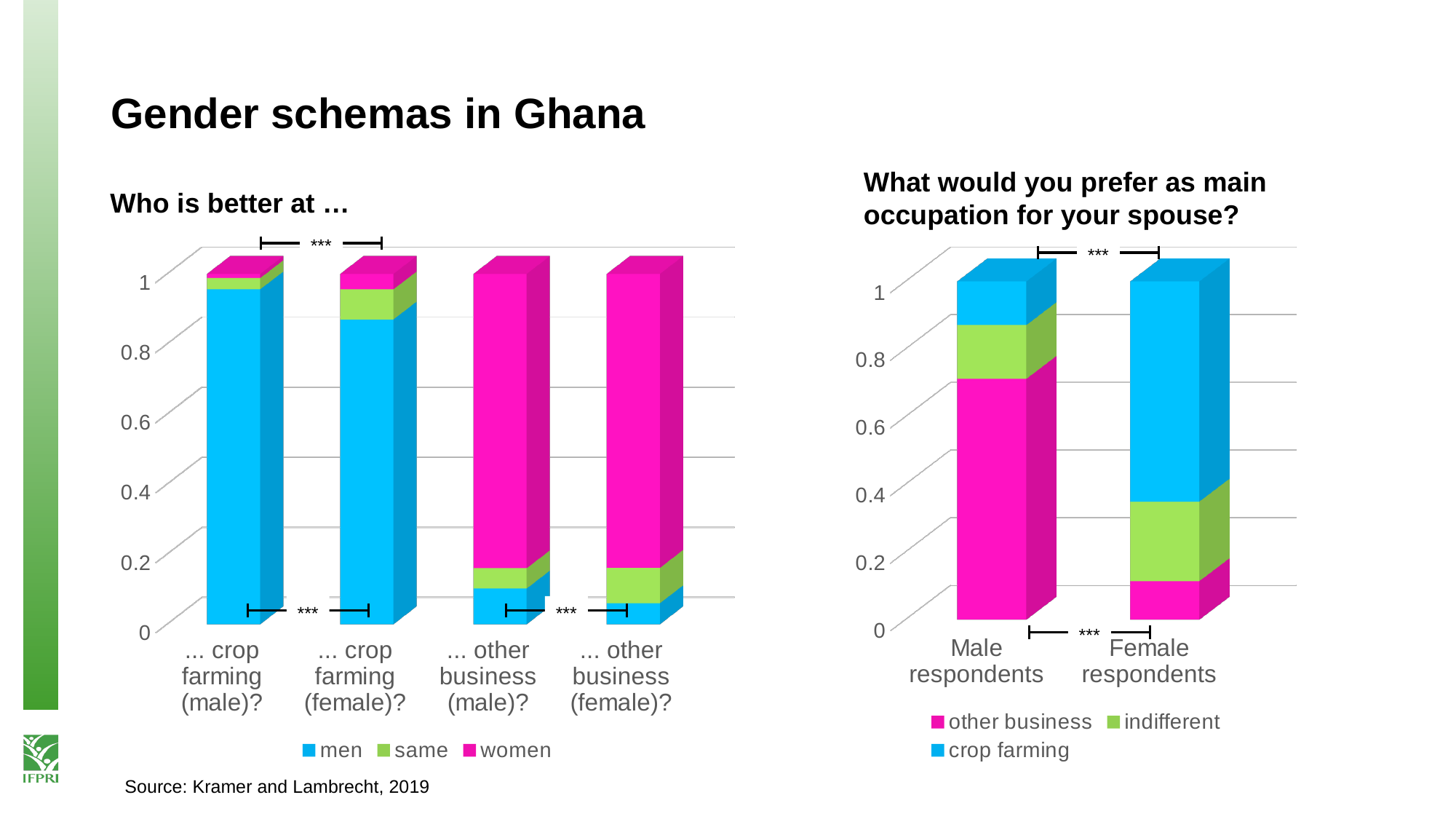
How many series does the legend of the 'Who is better at …' chart list? 3 In the 'Who is better at …' chart, is the 'women' share for '... other business (male)?' greater or less than 0.8? greater In the 'Who is better at …' chart, is the 'men' share for '... other business (female)?' greater or less than 0.2? less Which series is shown in blue in the 'What would you prefer as main occupation for your spouse?' chart? crop farming How many categories are shown on the x axis of the 'Who is better at …' chart? 4 What kind of chart is the 'Who is better at …' chart on the left? stacked bar chart In the 'What would you prefer as main occupation for your spouse?' chart, is the 'other business' share for Male respondents greater or less than 0.6? greater How many series does the legend of the 'What would you prefer as main occupation for your spouse?' chart list? 3 In the 'Who is better at …' chart, which category has the larger 'men' share: '... crop farming (male)?' or '... crop farming (female)?'? ... crop farming (male)? In the 'What would you prefer as main occupation for your spouse?' chart, which group has the larger 'other business' share: Male respondents or Female respondents? Male respondents How many categories are shown on the x axis of the 'What would you prefer as main occupation for your spouse?' chart? 2